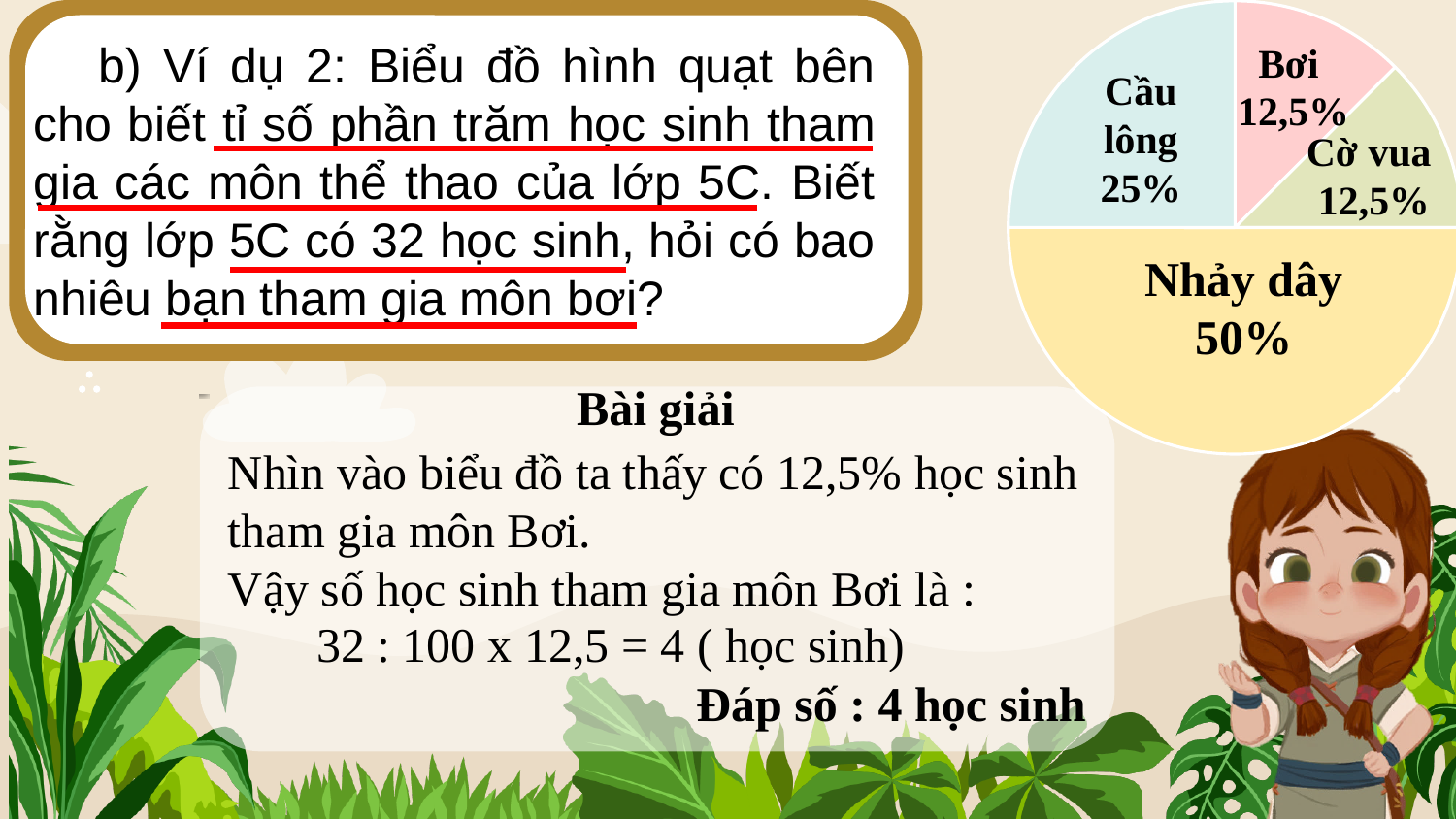
What kind of chart is shown on the slide? Pie chart What percentage does the Nhảy dây slice show? 50% What percentage is shown for Cờ vua? 12,5% How many slices does the pie chart have? 4 What is the difference between the percentages for Nhảy dây and Cầu lông? 25% What share of the pie does the Bơi slice represent? 12,5% Which is larger, the slice for Cầu lông or the slice for Bơi? Cầu lông What is the difference between the percentages for Cầu lông and Bơi? 12,5% What percentage of the pie chart is labelled for Bơi? 12,5% Which sport has the largest slice of the pie chart? Nhảy dây What percentage is shown for Cầu lông? 25% Which is larger, the slice for Nhảy dây or the slice for Cờ vua? Nhảy dây